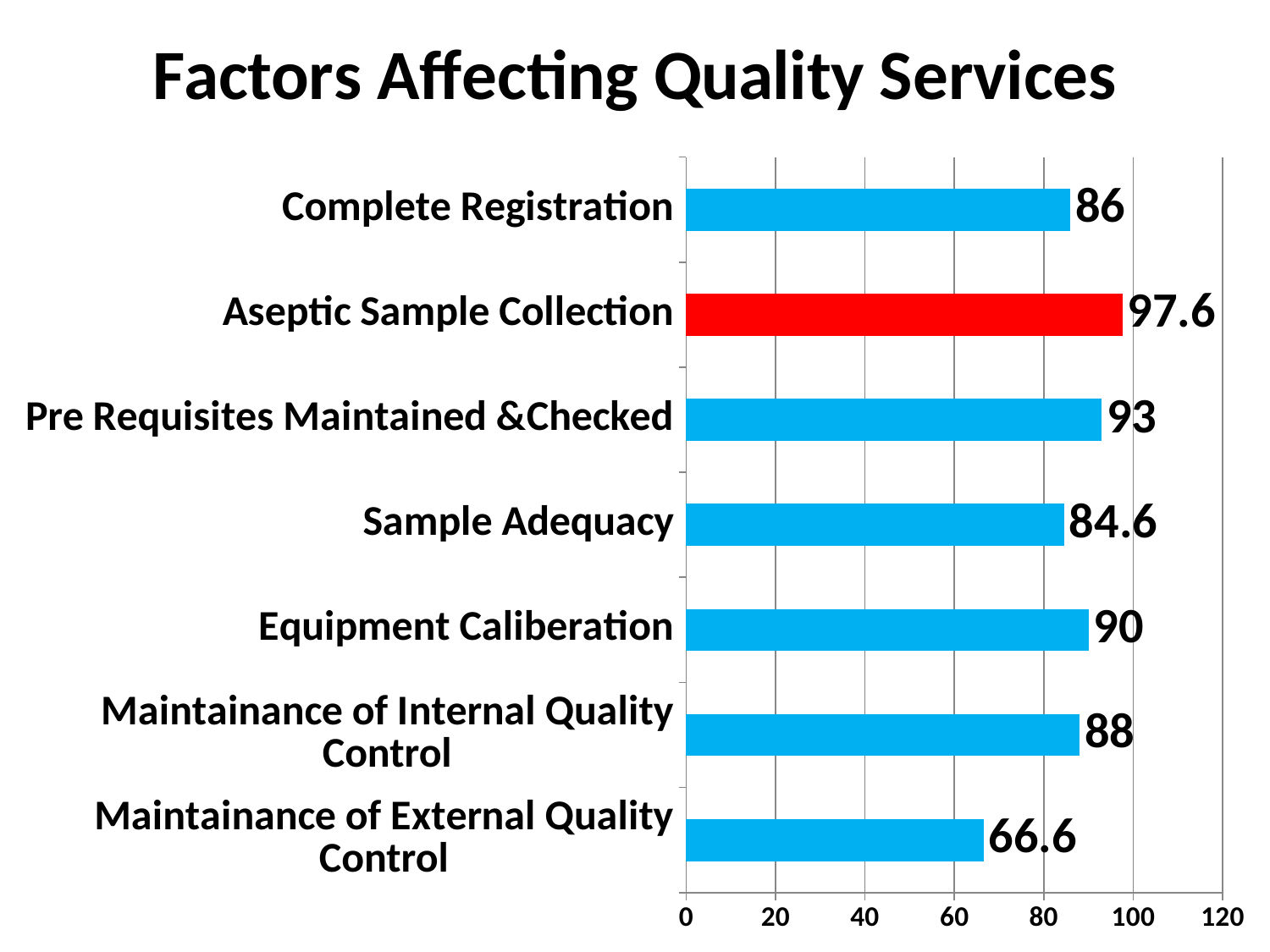
What kind of chart is shown on the slide? bar chart Is the value for Maintainance of External Quality Control greater or less than 80? less Which category has the highest value? Aseptic Sample Collection What is the difference between the values for Pre Requisites Maintained &Checked and Complete Registration? 7 Which category has the lowest value? Maintainance of External Quality Control What is the value for Sample Adequacy? 84.6 Which is larger, the value for Maintainance of Internal Quality Control or the value for Sample Adequacy? Maintainance of Internal Quality Control What is the value for Maintainance of External Quality Control? 66.6 What is the value for Equipment Caliberation? 90 What is the value for Aseptic Sample Collection? 97.6 How many categories are shown in the chart? 7 Which bar is coloured red rather than blue? Aseptic Sample Collection